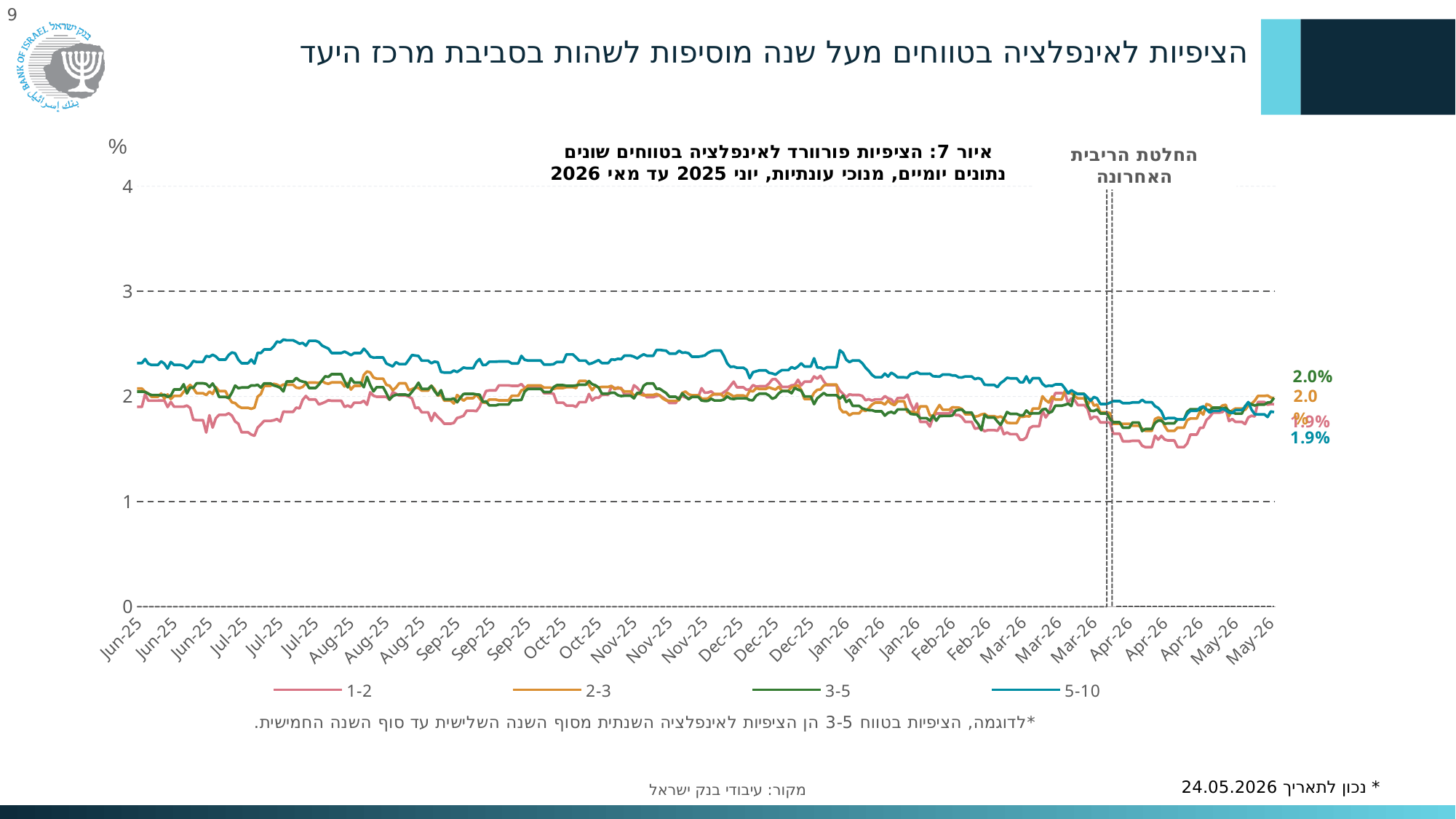
Is the value of the 1-2 series in Apr-26 greater or less than 2? less Is the value of the 1-2 series in Jul-25 greater or less than 2? less What kind of chart is shown on the slide? line chart In Jul-25, which series is higher: 5-10 or 1-2? 5-10 Is the value of the 5-10 series in Jul-25 greater or less than 2? greater What are the four series names listed in the legend? 1-2, 2-3, 3-5, 5-10 What is the end-of-period value labelled for the 5-10 series (blue line)? 1.9% Which series has the lowest values in Apr-26? 1-2 Which series has the highest values in Jun-25? 5-10 Does the 5-10 series rise or fall overall from Jun-25 to May-26? fall What is the end-of-period value labelled for the 3-5 series (green line)? 2.0% How many series does the legend list? 4